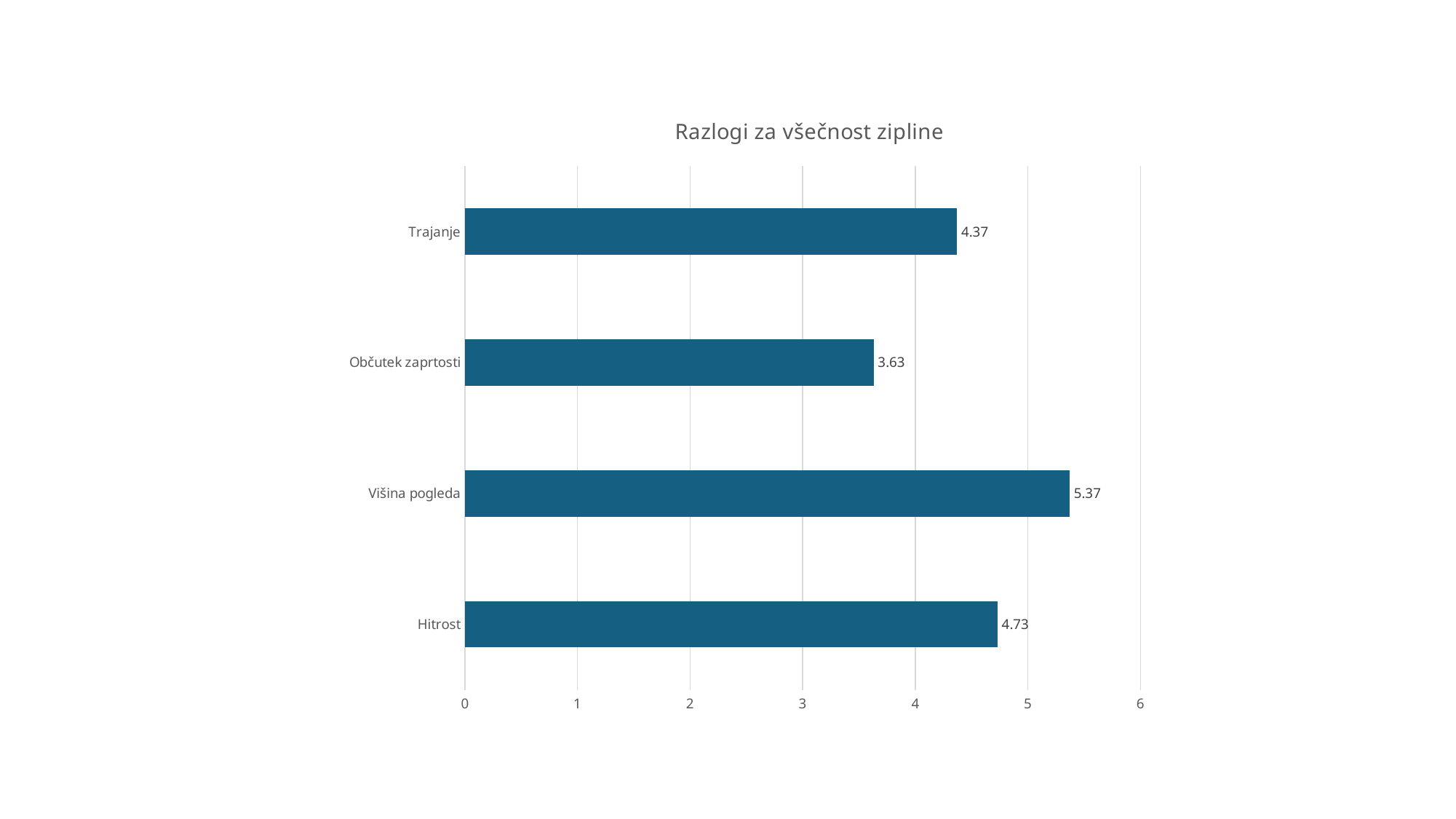
What is the value for Občutek zaprtosti? 3.63 What is the value for Hitrost? 4.73 What is the value for Trajanje? 4.37 Which category has the highest value? Višina pogleda Which category has the lowest value? Občutek zaprtosti What is the difference between the values for Višina pogleda and Občutek zaprtosti? 1.74 What is the value for Višina pogleda? 5.37 What is the title of the chart? Razlogi za všečnost zipline Is the value for Občutek zaprtosti greater or less than 4? less Which is larger, the value for Hitrost or the value for Trajanje? Hitrost What kind of chart is shown on the slide? bar chart How many categories are shown in the chart? 4